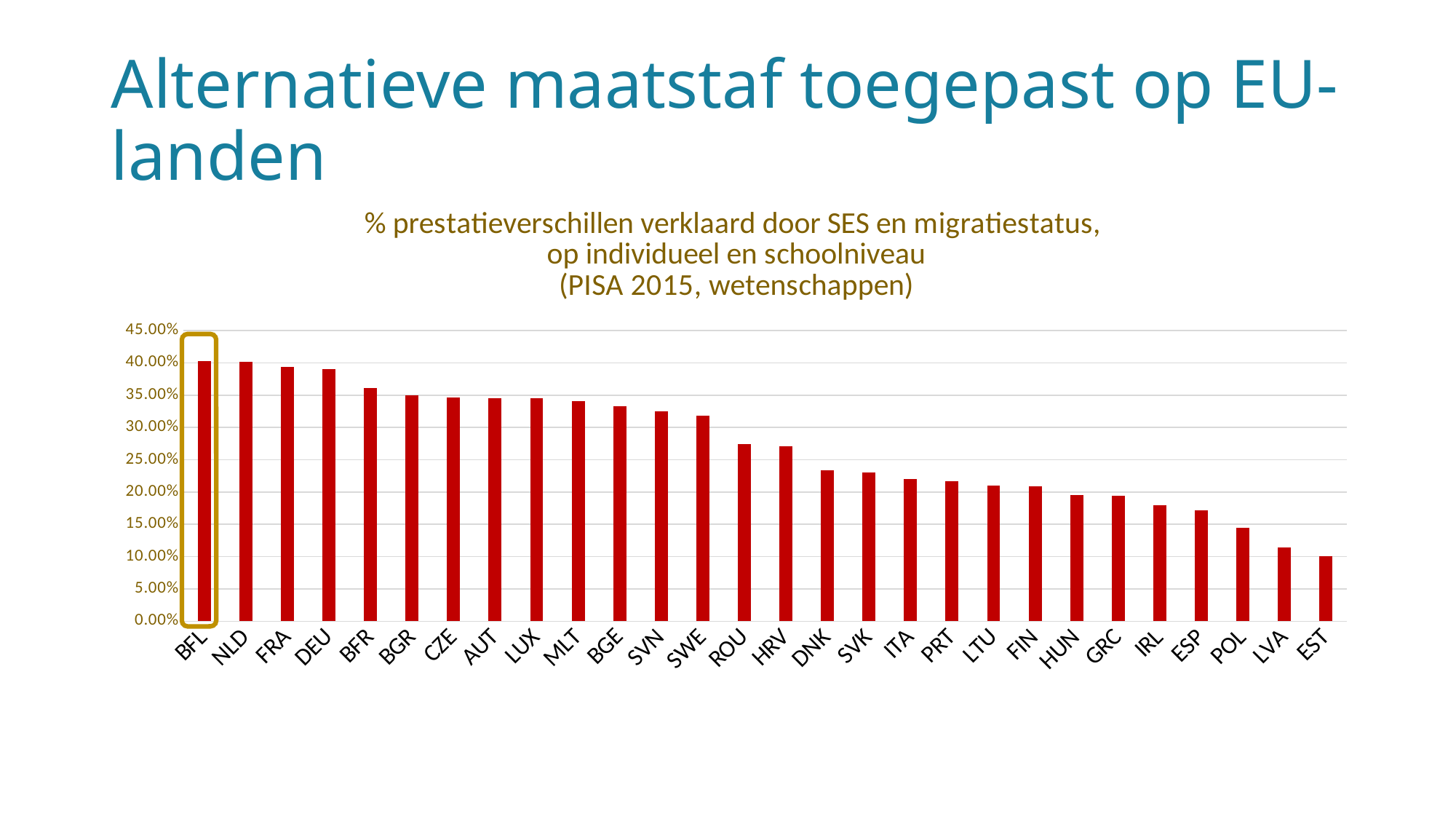
Is the value for SWE greater or less than 30.00%? greater Which has the larger value, ITA or IRL? ITA What kind of chart is shown on the slide? bar chart How many countries are shown on the x axis of the chart? 28 Which country has the lowest value in the chart? EST Is the value for EST greater or less than 15.00%? less Do the values rise or fall from left to right along the x axis? fall Is the value for ROU greater or less than 25.00%? greater Which has the larger value, BFR or SVN? BFR Which country's bar is highlighted with a gold outline on the chart? BFL